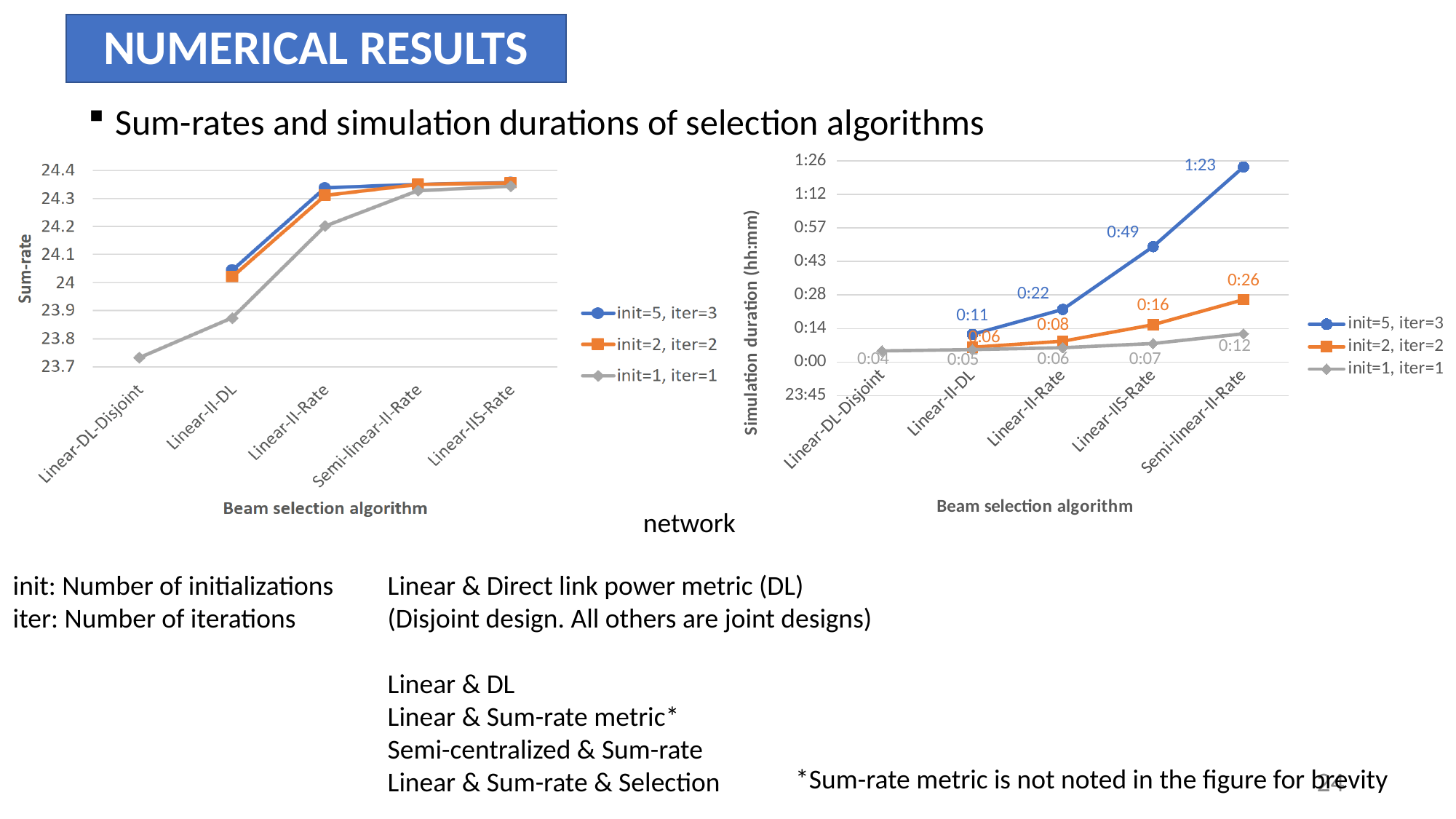
In the right chart (Simulation duration), what is the value for init=5, iter=3 at Semi-linear-II-Rate? 1:23 In the left chart (Sum-rate), is the value for init=1, iter=1 at Linear-DL-Disjoint greater or less than 23.8? less In the right chart (Simulation duration), what is the value for init=2, iter=2 at Linear-IIS-Rate? 0:16 In the right chart (Simulation duration), what is the value for init=1, iter=1 at Linear-DL-Disjoint? 0:04 In the right chart (Simulation duration), what is the difference between init=5, iter=3 and init=2, iter=2 at Linear-II-Rate? 0:14 In the right chart (Simulation duration), at Linear-II-Rate, which series has the larger value: init=5, iter=3 or init=2, iter=2? init=5, iter=3 In the right chart (Simulation duration), how many beam selection algorithms are shown on the x axis? 5 In the right chart (Simulation duration), which beam selection algorithm has the highest duration for init=5, iter=3? Semi-linear-II-Rate In the left chart (Sum-rate), how many series does the legend list? 3 In the left chart (Sum-rate), is the value for init=5, iter=3 at Linear-II-DL greater or less than 24? greater What kind of chart is the left chart (Sum-rate)? Line chart In the left chart (Sum-rate), does the init=1, iter=1 series rise or fall from Linear-DL-Disjoint to Linear-IIS-Rate? Rise